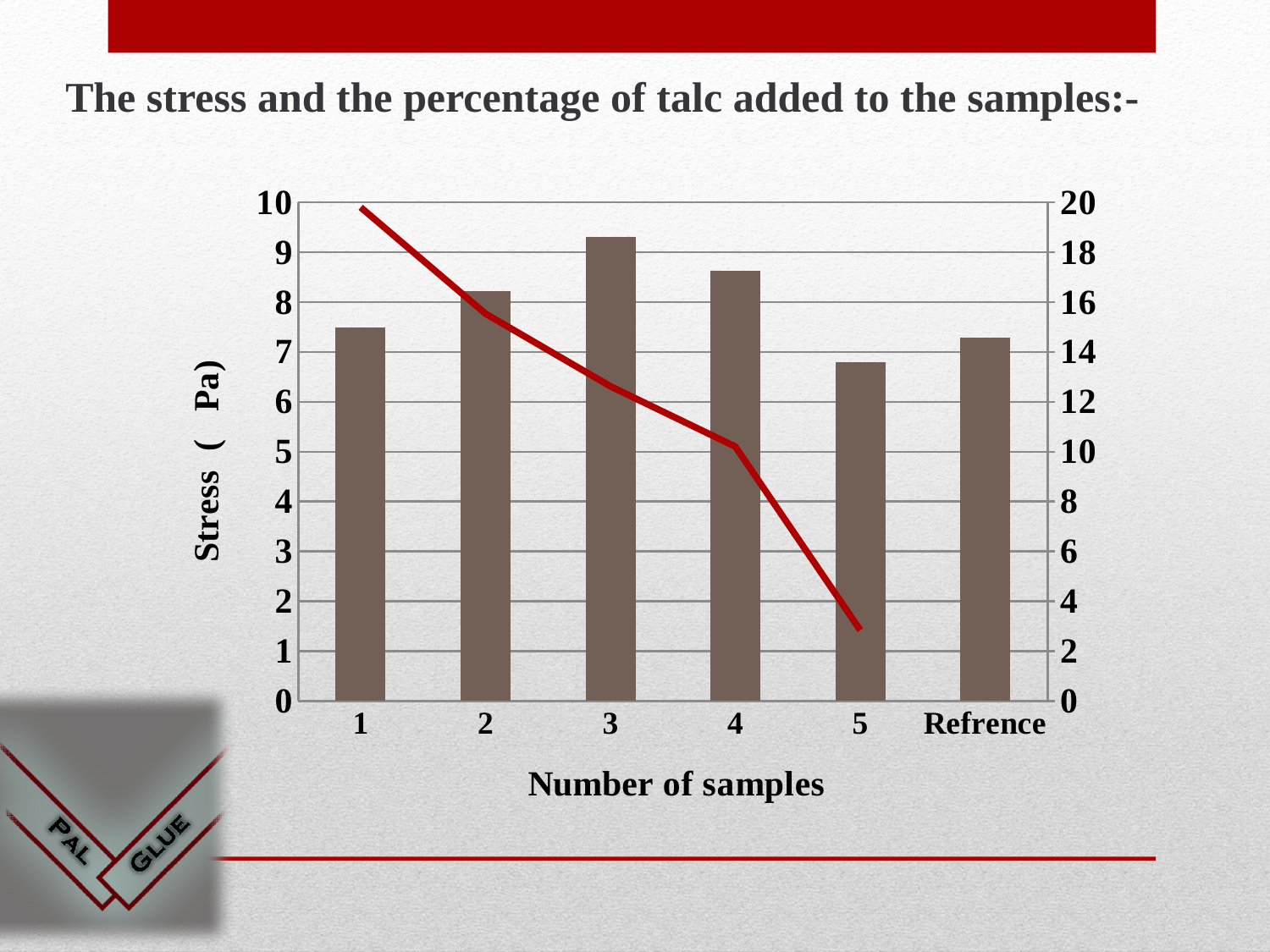
Which sample has the highest stress bar? 3 Is the stress value for sample 1 greater or less than 7? greater Is the stress value for sample 4 greater or less than 8? greater Which has the taller stress bar, sample 1 or sample 2? 2 What is the title of the x axis? Number of samples Which category has the lowest stress bar? 5 Does the red line rise or fall from sample 1 to sample 5? Fall On the right-hand axis, is the line value at sample 5 greater or less than 4? less What is the title of the left-hand y axis? Stress ( Pa) How many categories are shown on the x axis? 6 Is the stress bar for sample 3 taller than the bar for sample 4? Yes